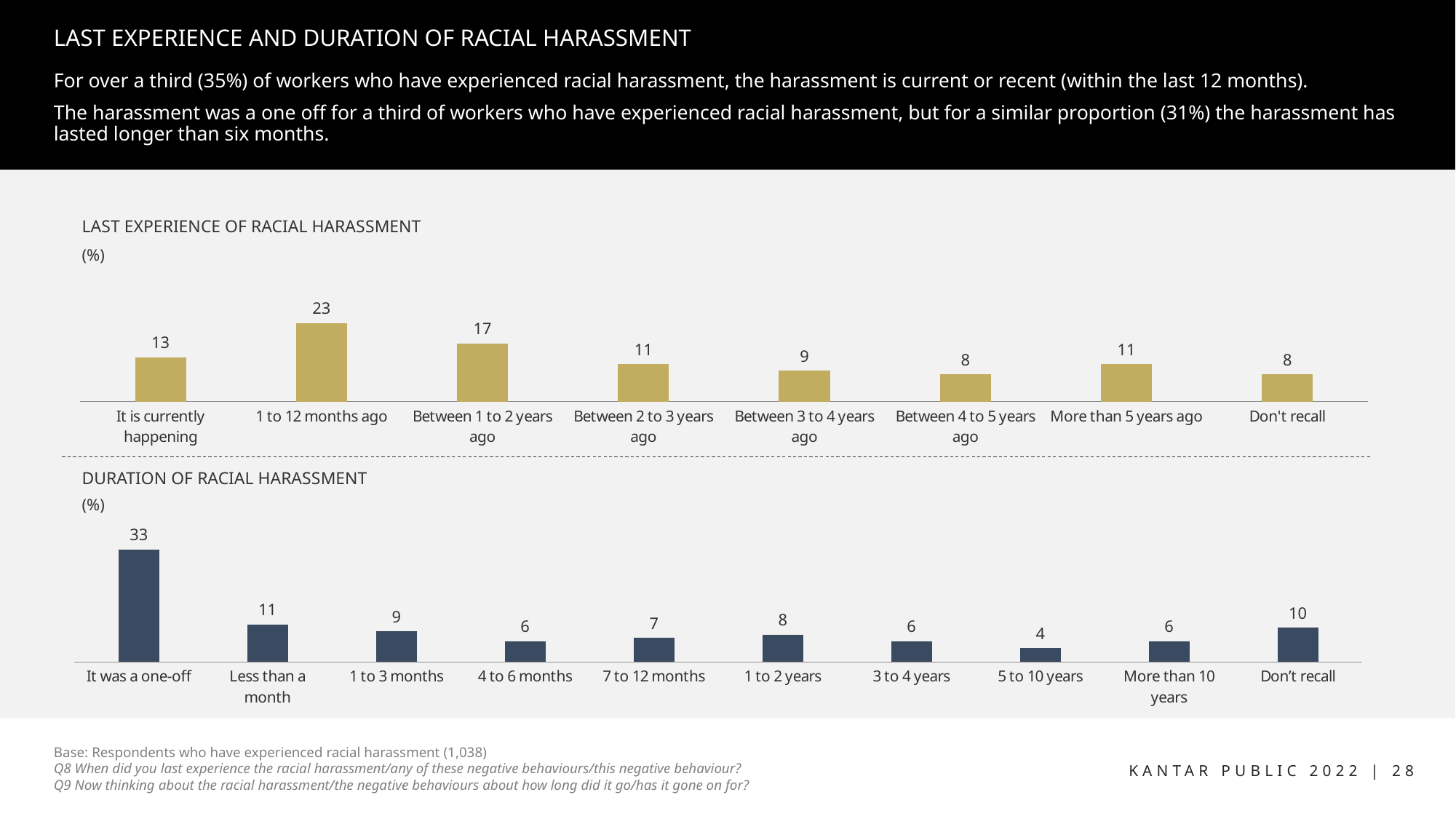
How many categories are shown in the 'Duration of racial harassment' chart? 10 In the 'Last experience of racial harassment' chart, what is the difference between '1 to 12 months ago' and 'Between 1 to 2 years ago'? 6 In the 'Last experience of racial harassment' chart, what is the value for '1 to 12 months ago'? 23 In the 'Duration of racial harassment' chart, which category has the lowest value? 5 to 10 years In the 'Duration of racial harassment' chart, what is the value for 'Don't recall'? 10 What type of chart is the 'Duration of racial harassment' chart? Bar chart In the 'Duration of racial harassment' chart, which is larger: 'Less than a month' or '1 to 3 months'? Less than a month In the 'Duration of racial harassment' chart, what is the value for 'It was a one-off'? 33 In the 'Last experience of racial harassment' chart, which category has the highest value? 1 to 12 months ago In the 'Duration of racial harassment' chart, what is the difference between 'It was a one-off' and 'Less than a month'? 22 In the 'Last experience of racial harassment' chart, what is the value for 'It is currently happening'? 13 How many categories are shown in the 'Last experience of racial harassment' chart? 8